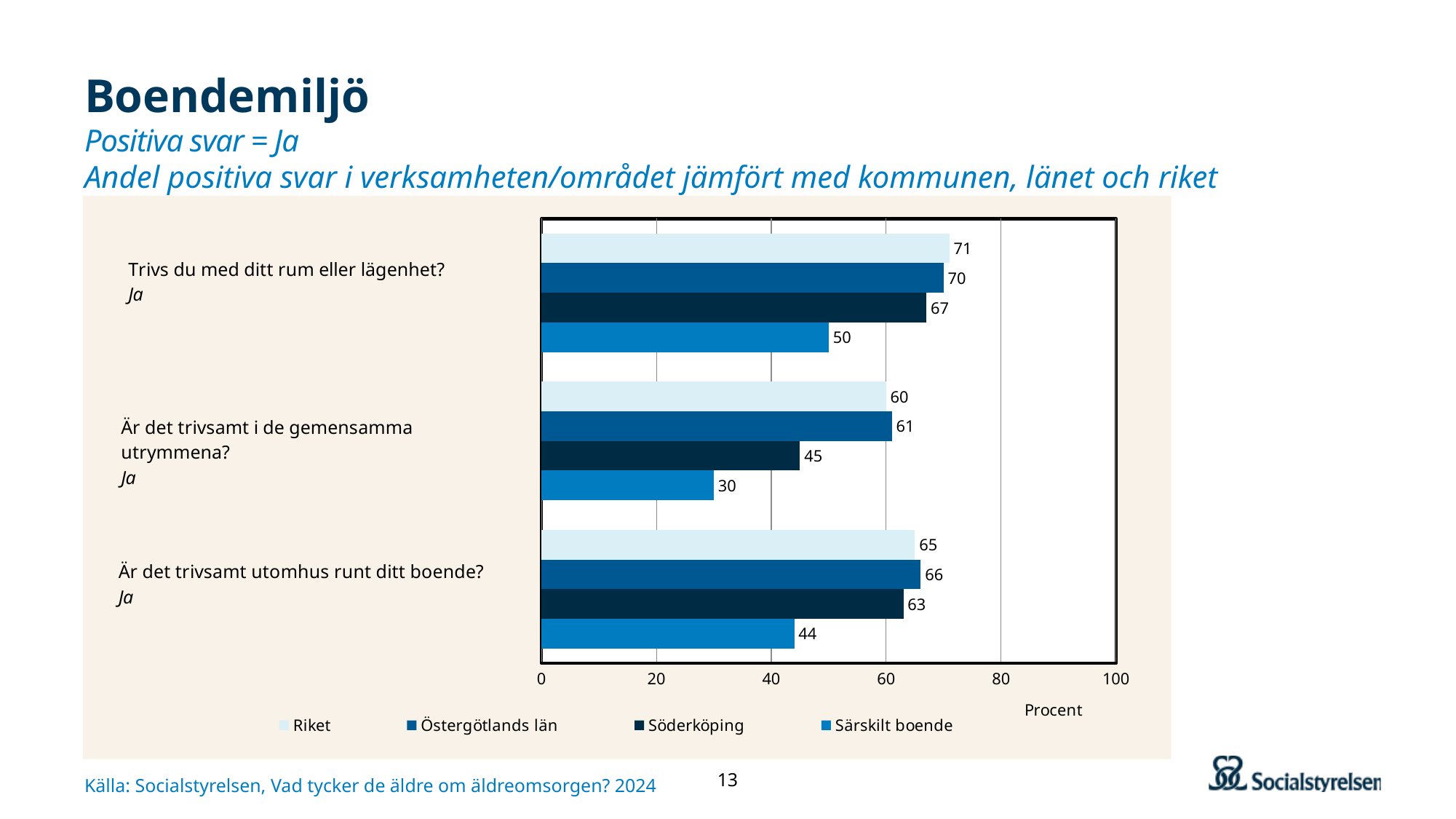
Which series has the highest value on the question "Trivs du med ditt rum eller lägenhet?"? Riket What is the value for Söderköping on the question "Är det trivsamt utomhus runt ditt boende?"? 63 How many questions (categories) are shown in the chart? 3 Which is larger on the question "Är det trivsamt i de gemensamma utrymmena?": Söderköping or Särskilt boende? Söderköping Which series has the lowest value on the question "Är det trivsamt i de gemensamma utrymmena?"? Särskilt boende What is the value for Riket on the question "Är det trivsamt i de gemensamma utrymmena?"? 60 Is the value for Särskilt boende on "Är det trivsamt utomhus runt ditt boende?" greater or less than 60? less What unit is shown on the x axis of the chart? Procent What is the difference between Östergötlands län and Särskilt boende on the question "Är det trivsamt utomhus runt ditt boende?"? 22 What kind of chart is shown on the slide? Bar chart What is the value for Särskilt boende on the question "Trivs du med ditt rum eller lägenhet?"? 50 How many series does the legend list? 4